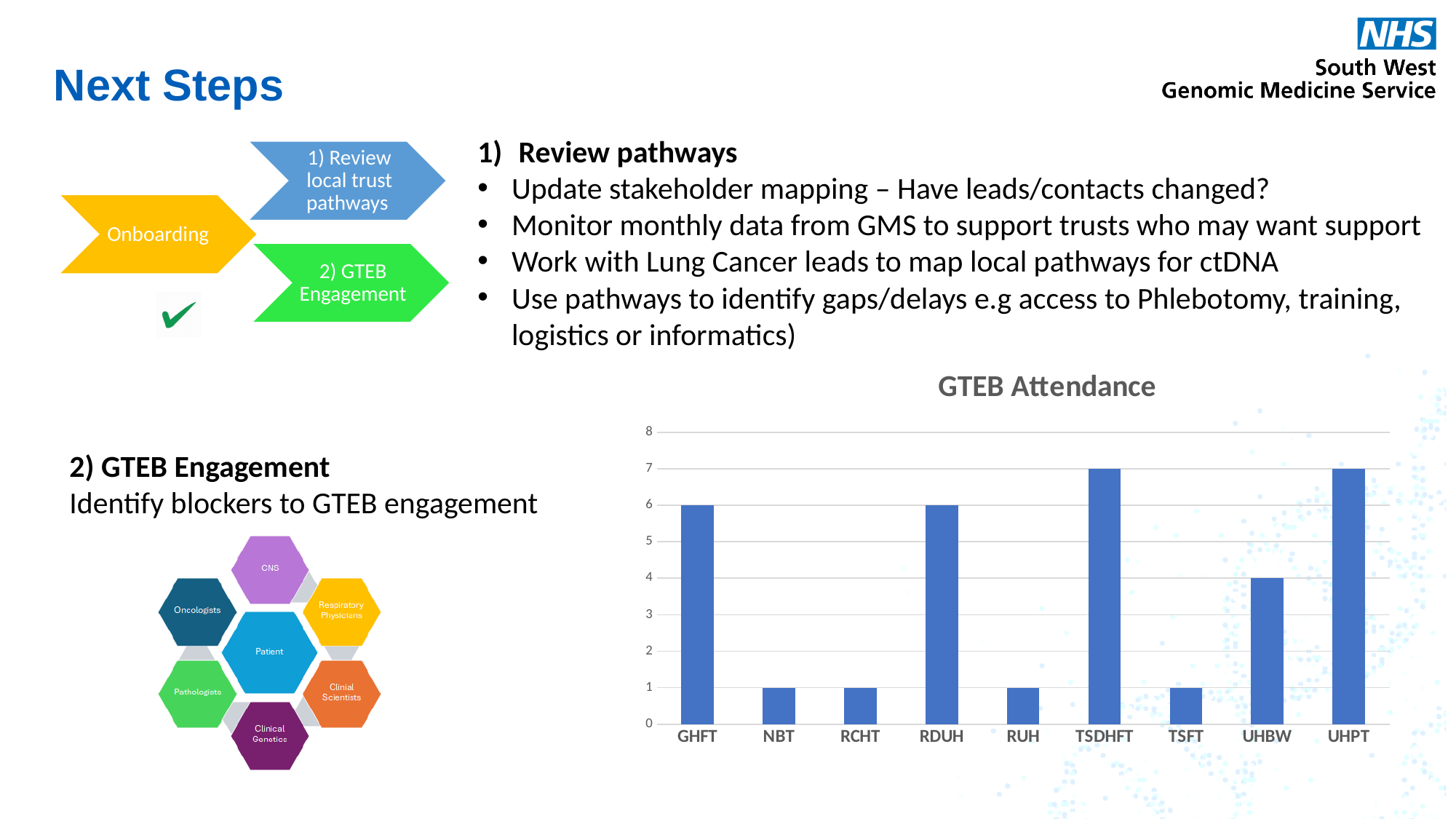
What is the title of the chart on the slide? GTEB Attendance How many trusts are shown on the x axis of the GTEB Attendance chart? 9 Is the GTEB attendance value for UHBW greater or less than 2? greater Which has the higher GTEB attendance, RUH or RDUH? RDUH What is the GTEB attendance value for NBT? 1 What is the GTEB attendance value for TSDHFT? 7 What kind of chart is the GTEB Attendance chart? bar chart What is the difference in GTEB attendance between UHPT and UHBW? 3 What is the GTEB attendance value for GHFT? 6 What is the GTEB attendance value for UHBW? 4 What is the highest value shown on the y axis of the GTEB Attendance chart? 8 Which has the higher GTEB attendance, GHFT or UHBW? GHFT